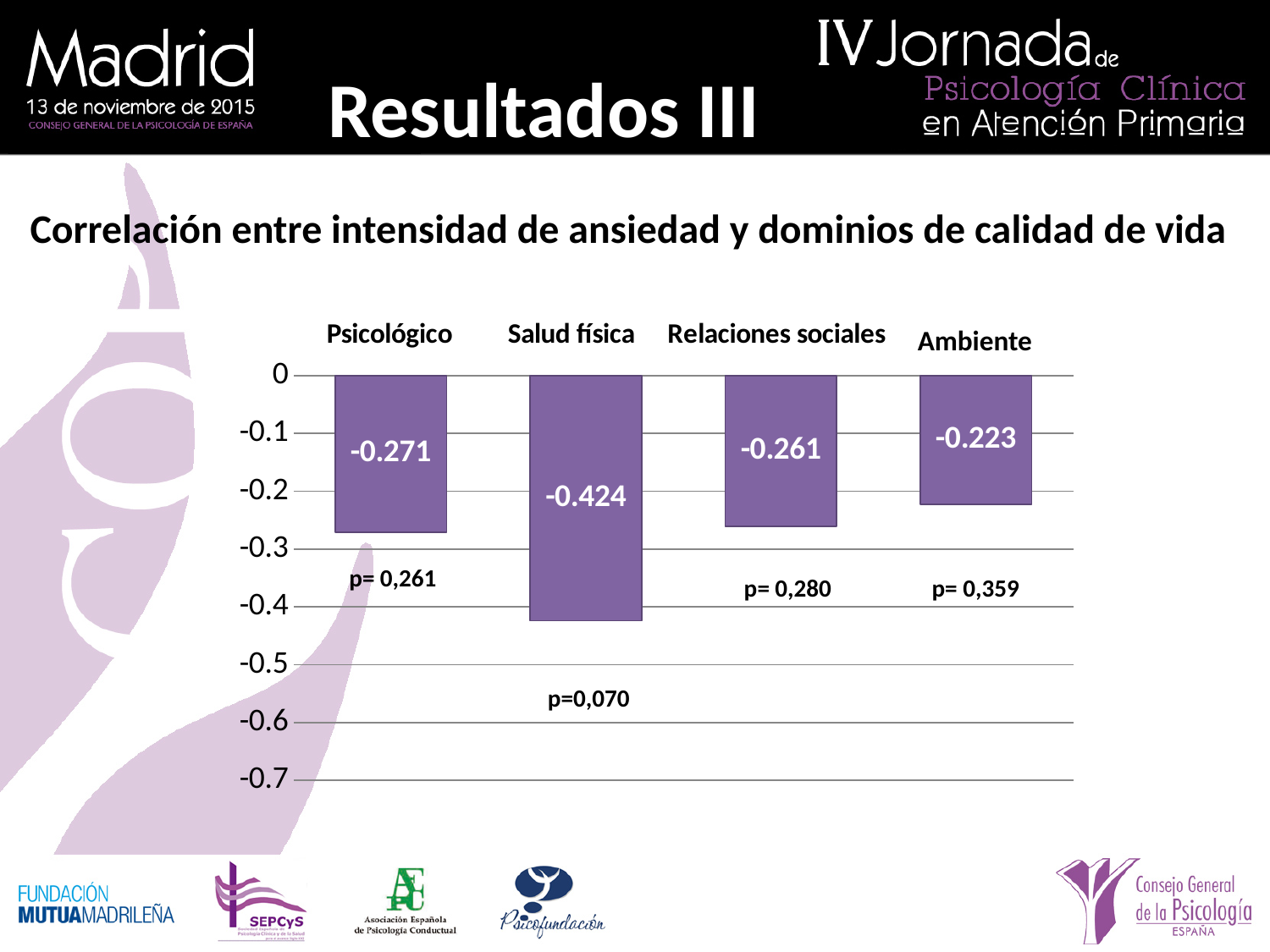
Which value is larger, Psicológico or Relaciones sociales? Relaciones sociales How many domains (bars) are plotted in the chart? 4 What kind of chart is shown on the slide? Bar chart What is the correlation value shown for Relaciones sociales? -0.261 What is the difference between the values for Relaciones sociales and Ambiente? 0.038 What is the correlation value shown for Salud física? -0.424 Which domain has the highest (least negative) correlation value? Ambiente Which domain has the lowest (most negative) correlation value? Salud física What is the difference between the values for Salud física and Psicológico? 0.153 What is the correlation value shown for Ambiente? -0.223 What is the correlation value shown for Psicológico? -0.271 What p-value is printed below the Salud física bar? p=0,070